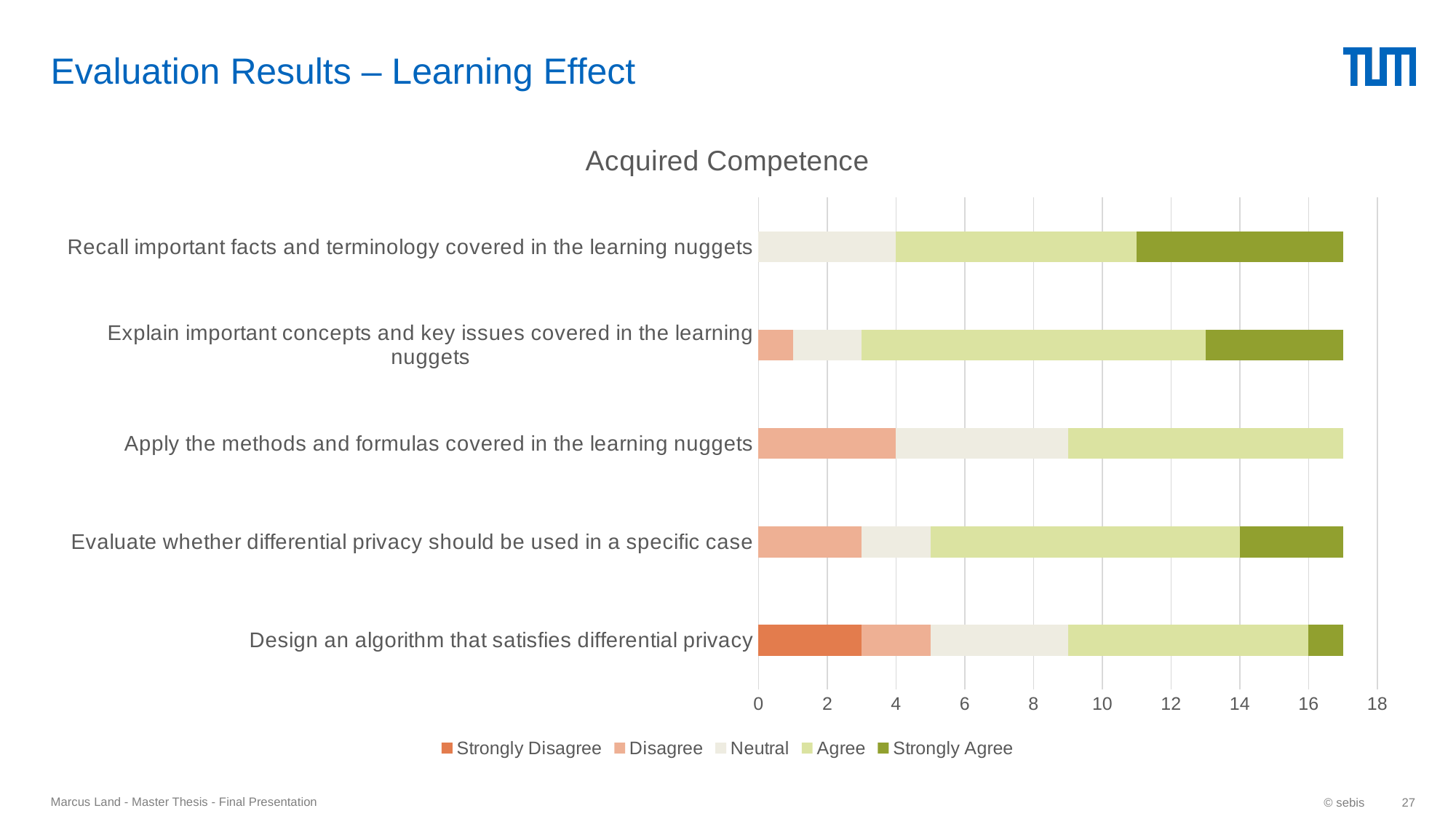
Which has the larger Strongly Agree segment: 'Recall important facts and terminology covered in the learning nuggets' or 'Explain important concepts and key issues covered in the learning nuggets'? Recall important facts and terminology covered in the learning nuggets What is the title of the chart? Acquired Competence Is the Strongly Agree value for 'Design an algorithm that satisfies differential privacy' greater or less than 2? less Which category has the largest Strongly Agree segment? Recall important facts and terminology covered in the learning nuggets Which category has no Strongly Agree segment at all? Apply the methods and formulas covered in the learning nuggets What is the Disagree value for 'Apply the methods and formulas covered in the learning nuggets'? 4 How many categories (competence statements) are plotted in the chart? 5 Is the Strongly Disagree value for 'Design an algorithm that satisfies differential privacy' greater or less than 2? greater How many series does the legend list? 5 What is the Neutral value for 'Recall important facts and terminology covered in the learning nuggets'? 4 What kind of chart is shown on the slide? bar chart Which series does the legend list last? Strongly Agree